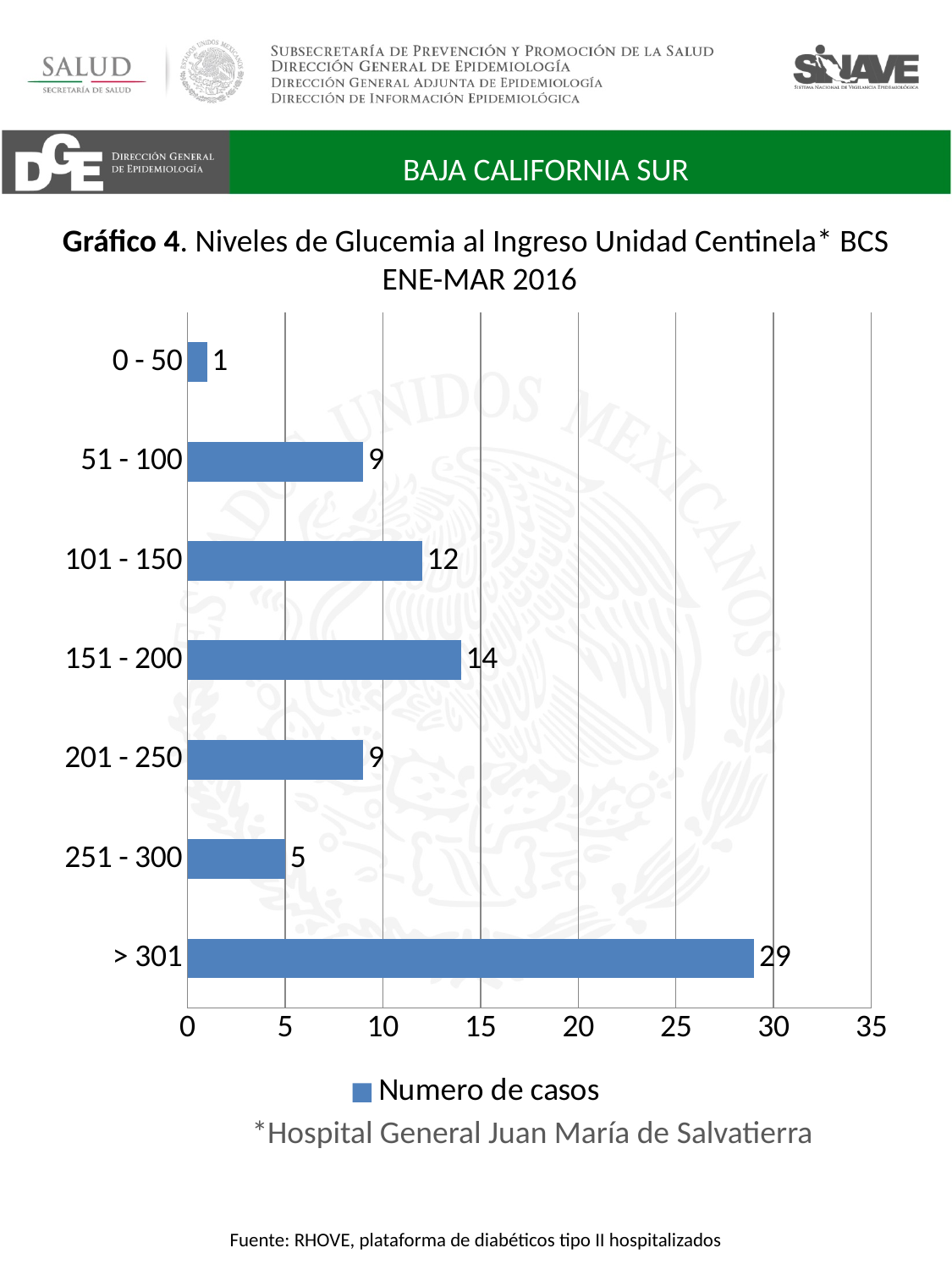
How many series does the legend list? 1 What kind of chart is shown on the slide? Bar chart Which has more cases, "101 - 150" or "251 - 300"? 101 - 150 What is the number of cases for the glucose level category "> 301"? 29 What is the number of cases for the "0 - 50" category? 1 Which glucose level category has the lowest number of cases? 0 - 50 Which glucose level category has the highest number of cases? > 301 Is the value for "> 301" greater or less than 25? greater What is the difference in number of cases between the "> 301" and "151 - 200" categories? 15 What is the number of cases for the "151 - 200" category? 14 How many glucose level categories are shown in the chart? 7 What is the legend entry of the chart? Numero de casos